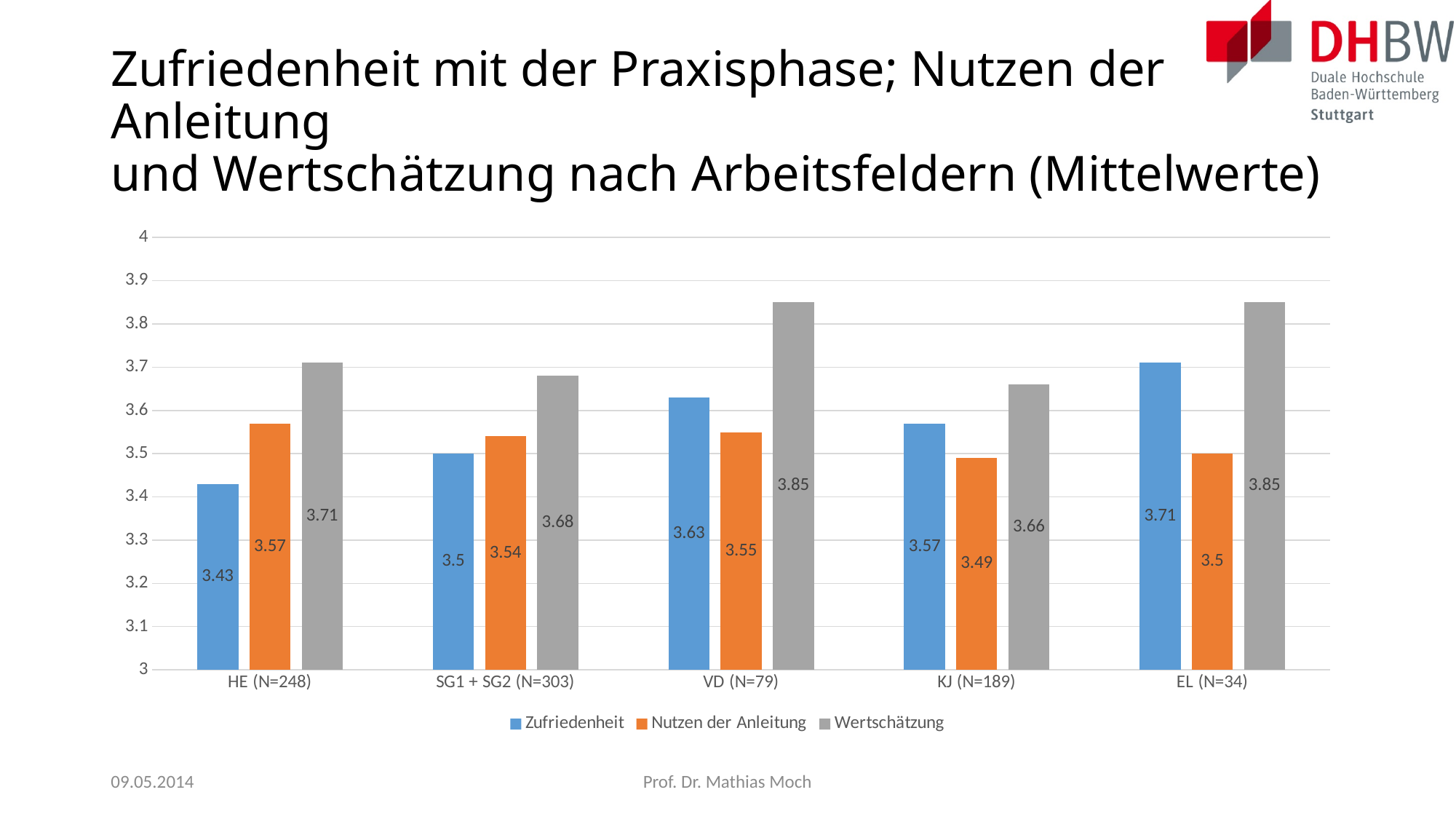
What is the Zufriedenheit value for HE (N=248)? 3.43 What is the Nutzen der Anleitung value for VD (N=79)? 3.55 What is the difference between the Wertschätzung and Zufriedenheit values for HE (N=248)? 0.28 Which is larger for SG1 + SG2 (N=303): Zufriedenheit or Nutzen der Anleitung? Nutzen der Anleitung What kind of chart is shown on the slide? Bar chart Which category has the highest Zufriedenheit value? EL (N=34) How many categories are shown on the x axis? 5 What is the Wertschätzung value for KJ (N=189)? 3.66 Which colour represents the Wertschätzung series? Grey Which category has the lowest Zufriedenheit value? HE (N=248) Which category has the lowest Nutzen der Anleitung value? KJ (N=189) How many series does the legend list? 3